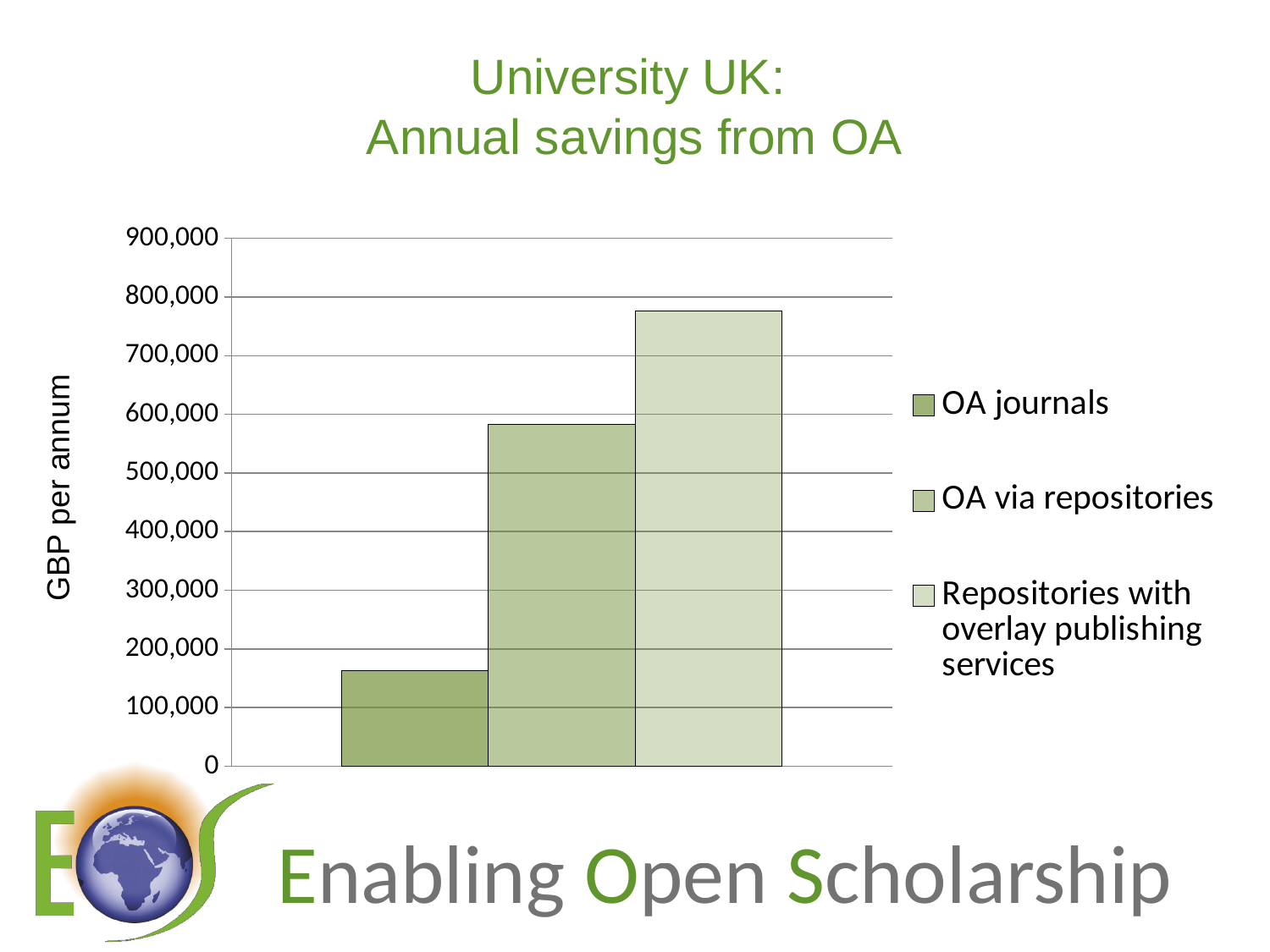
Is the value for OA via repositories greater or less than 500,000? greater Is the value for OA journals greater or less than 200,000? less Which is larger, the value for OA journals or the value for OA via repositories? OA via repositories Which series has the highest annual savings? Repositories with overlay publishing services What kind of chart is shown on the slide? bar chart Which series has the lowest annual savings? OA journals What is the label on the vertical axis of the chart? GBP per annum How many entries does the legend list? 3 What is the title of the chart? University UK: Annual savings from OA Is the value for OA journals greater or less than 100,000? greater How many bars are plotted in the chart? 3